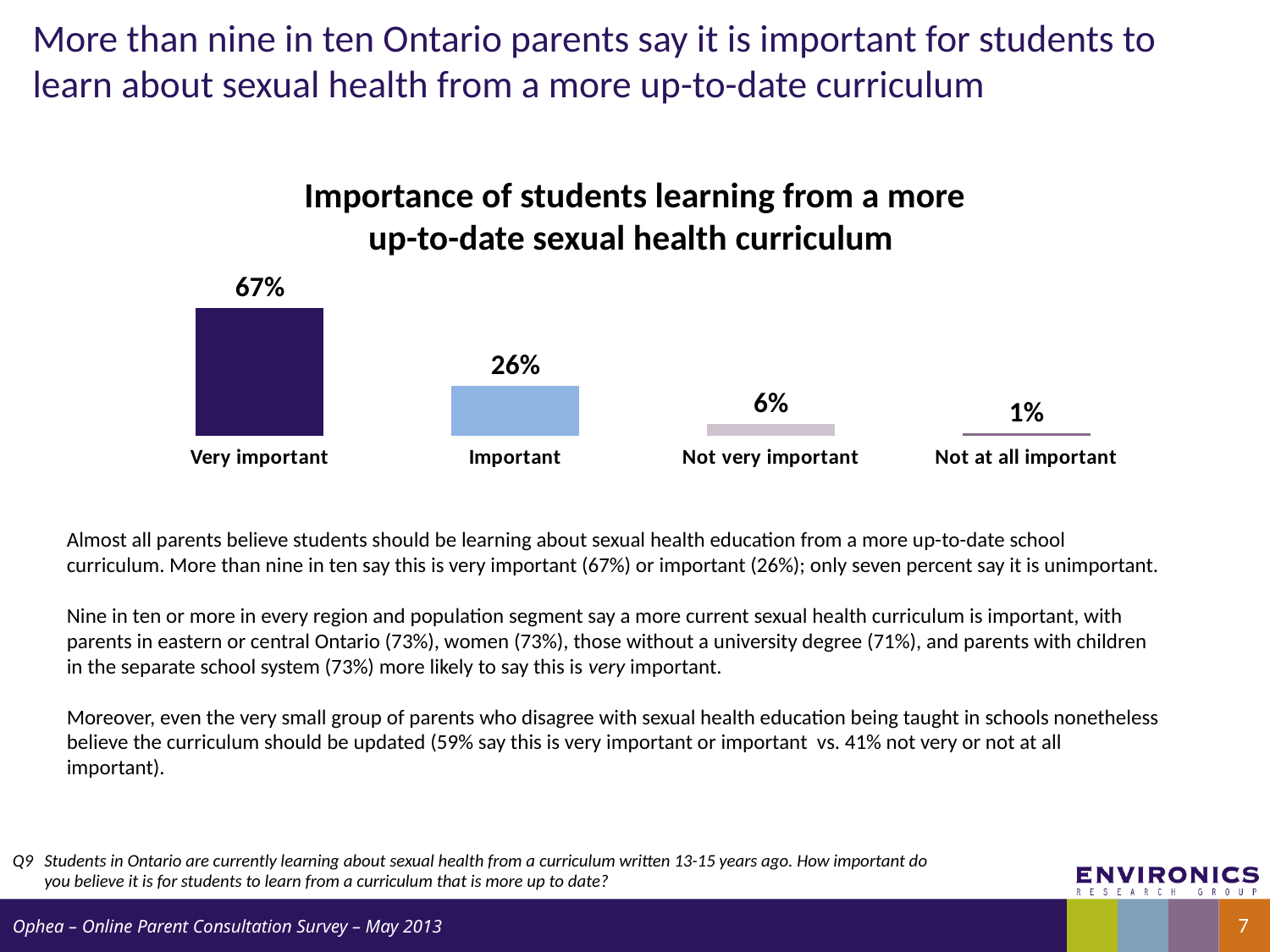
Which is larger, the value for 'Not very important' or 'Not at all important'? Not very important Which category has the lowest value in the chart? Not at all important What is the value shown for the 'Important' category? 26% How many categories are shown in the chart? 4 What kind of chart is shown on the slide? Bar chart Do the values rise or fall moving from left to right across the categories? Fall What percentage of parents say it is not very important? 6% Which category has the highest value in the chart? Very important What is the title of the chart? Importance of students learning from a more up-to-date sexual health curriculum What is the value for 'Not at all important'? 1% What percentage of parents say it is very important for students to learn from a more up-to-date sexual health curriculum? 67% What is the difference between the 'Very important' and 'Important' values? 41 percentage points